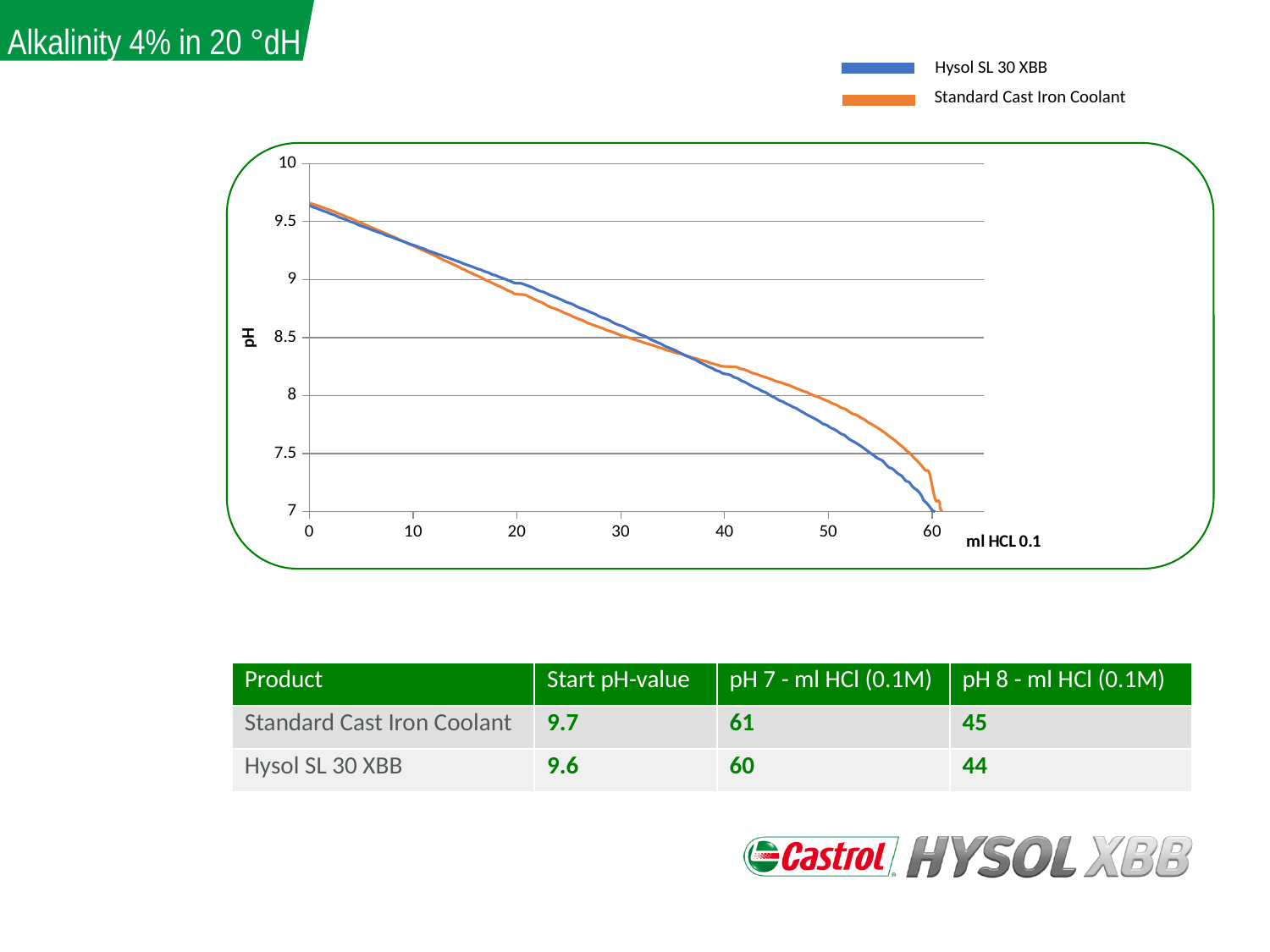
Does the pH rise or fall as ml HCL 0.1 increases along the x axis? fall At 50 ml HCL, which series has the higher pH, Hysol SL 30 XBB or Standard Cast Iron Coolant? Standard Cast Iron Coolant What is the label of the vertical axis of the chart? pH At 20 ml HCL, which series has the higher pH, Hysol SL 30 XBB or Standard Cast Iron Coolant? Hysol SL 30 XBB Is the pH of Standard Cast Iron Coolant at 20 ml HCL greater or less than 9? less Is the pH of Standard Cast Iron Coolant at 40 ml HCL greater or less than 8.5? less Is the pH of Hysol SL 30 XBB at 10 ml HCL greater or less than 9? greater How many series does the chart's legend list? 2 What kind of chart is shown on the slide? line chart Which series is drawn in orange in the chart? Standard Cast Iron Coolant